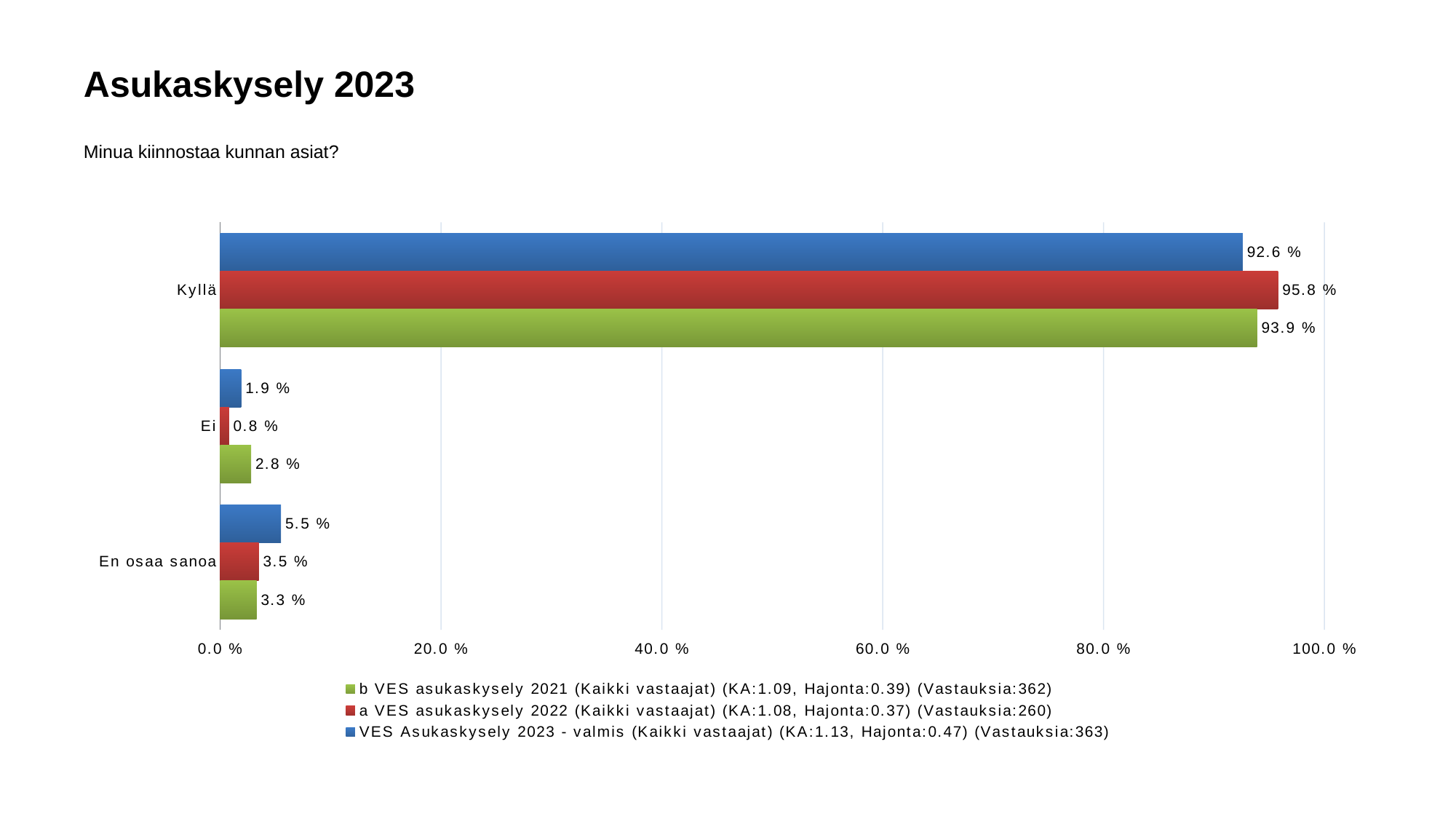
What question is the chart about, as shown in the subtitle? Minua kiinnostaa kunnan asiat? Which category has the lowest value in the a VES asukaskysely 2022 series? Ei How many categories are shown on the chart? 3 How many series does the legend list? 3 What is the value for Ei in the a VES asukaskysely 2022 series? 0.8 % What is the difference between the 2022 and 2023 values for Kyllä? 3.2 % Which is larger for En osaa sanoa: the 2023 value or the 2021 value? 2023 value (5.5 %) Is the value for Kyllä in the b VES asukaskysely 2021 series greater or less than 80.0 %? greater What kind of chart is shown on the slide? Bar chart What is the value for En osaa sanoa in the b VES asukaskysely 2021 series? 3.3 % What is the value for Kyllä in the VES Asukaskysely 2023 - valmis series? 92.6 % Which category has the highest value in the VES Asukaskysely 2023 - valmis series? Kyllä